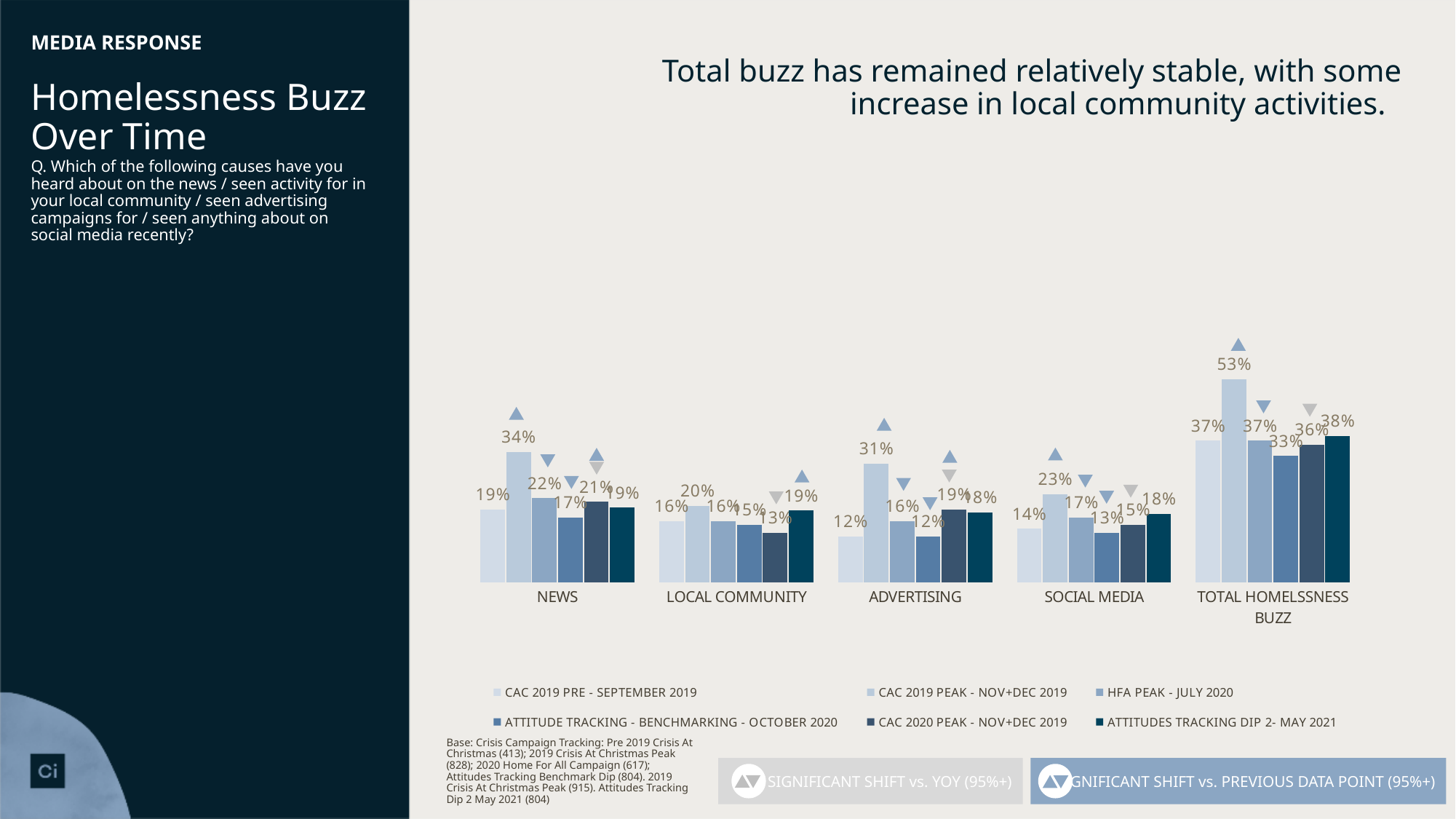
How many series does the legend list? 6 What is the value for LOCAL COMMUNITY in the CAC 2020 PEAK - NOV+DEC 2019 series? 13% What is the difference between the CAC 2019 PEAK - NOV+DEC 2019 value and the HFA PEAK - JULY 2020 value for ADVERTISING? 15% What kind of chart is shown on the slide? Bar chart For SOCIAL MEDIA, which is larger: the HFA PEAK - JULY 2020 value or the ATTITUDES TRACKING DIP 2- MAY 2021 value? ATTITUDES TRACKING DIP 2- MAY 2021 What is the value for TOTAL HOMELSSNESS BUZZ in the ATTITUDES TRACKING DIP 2- MAY 2021 series? 38% Which category has the lowest value in the CAC 2019 PRE - SEPTEMBER 2019 series? ADVERTISING How many categories are shown on the x axis of the chart? 5 Which category has the highest value in the CAC 2019 PEAK - NOV+DEC 2019 series? TOTAL HOMELSSNESS BUZZ What is the value for ADVERTISING in the CAC 2019 PRE - SEPTEMBER 2019 series? 12% What is the difference between the CAC 2019 PEAK - NOV+DEC 2019 value and the CAC 2019 PRE - SEPTEMBER 2019 value for TOTAL HOMELSSNESS BUZZ? 16% What is the value for NEWS in the CAC 2019 PEAK - NOV+DEC 2019 series? 34%